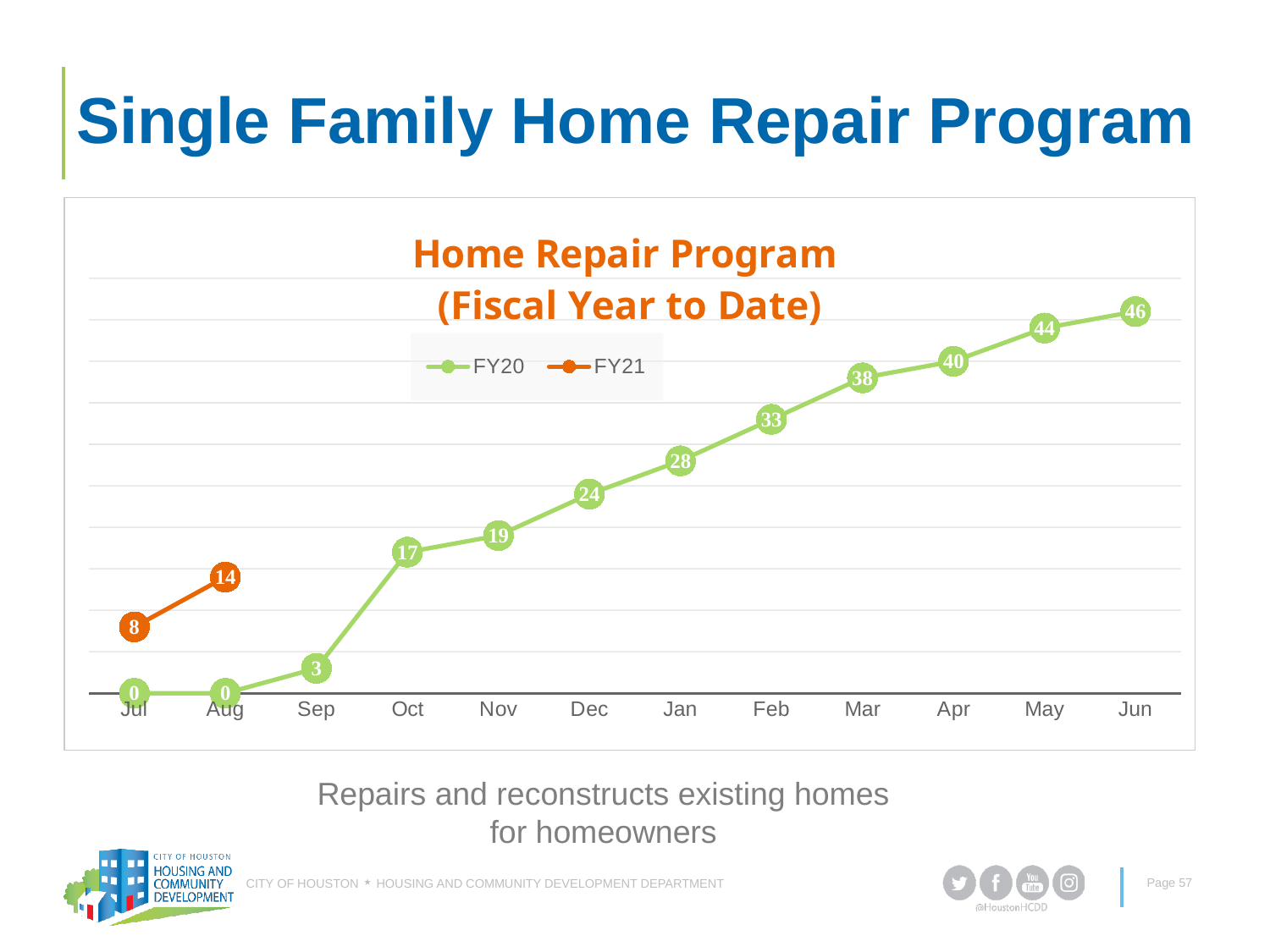
How many series does the legend list? 2 What is the difference between the FY20 values for Mar and Feb? 5 What kind of chart is this? Line chart What is the FY21 value for Aug? 14 Which is larger for Jul: the FY20 value or the FY21 value? FY21 What is the FY20 value for Dec? 24 What is the difference between the FY21 and FY20 values for Aug? 14 Do the FY20 values rise or fall from Sep to Jun? Rise What is the FY20 value for Jun? 46 Which month has the highest FY20 value? Jun How many months are shown on the x axis? 12 What is the FY21 value for Jul? 8